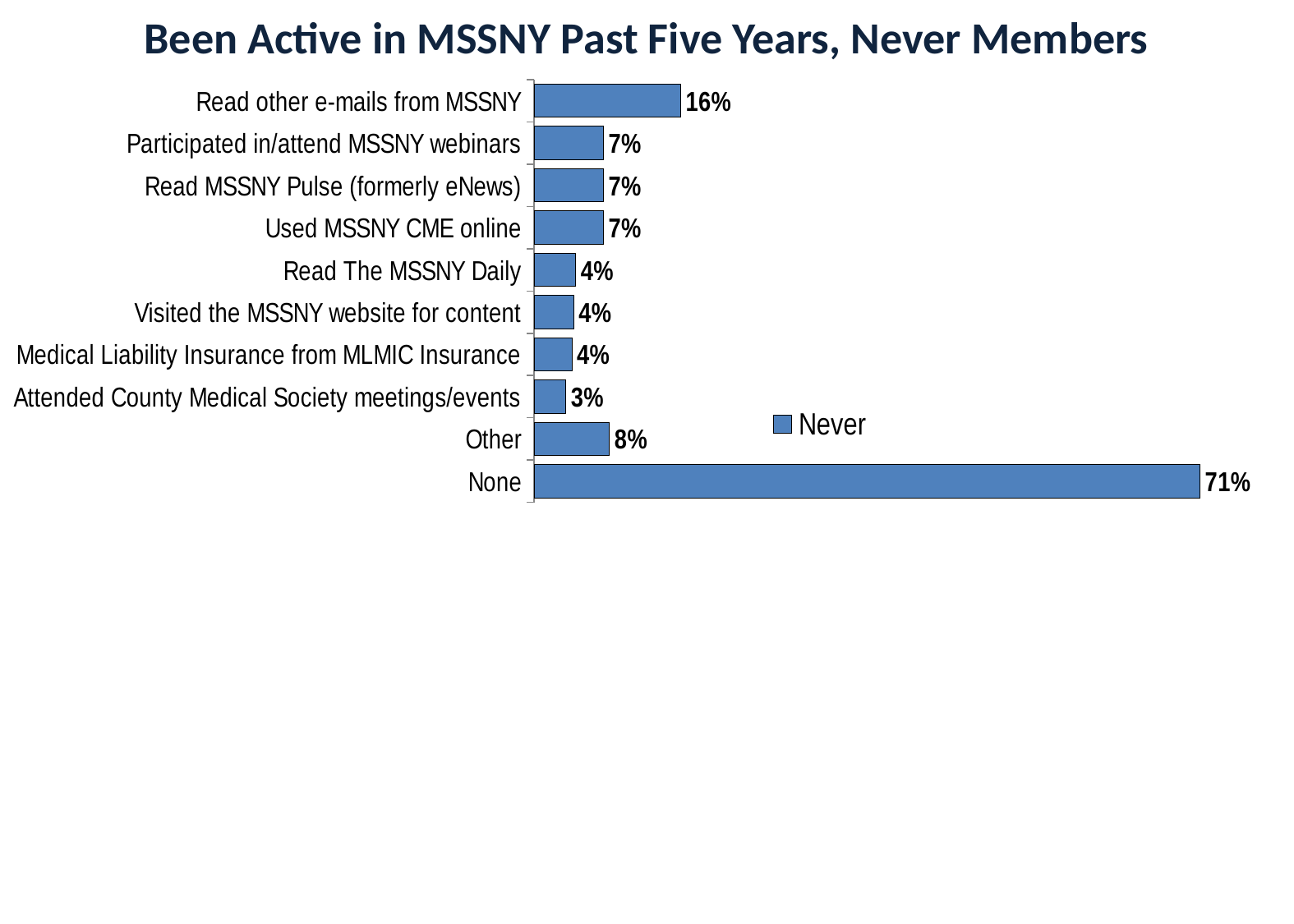
What kind of chart is shown on the slide? Bar chart How many categories are shown in the chart? 10 How many series does the legend list? 1 What is the value for "Used MSSNY CME online"? 7% What is the value for "None"? 71% Which is larger, the value for "Other" or the value for "Read The MSSNY Daily"? Other What is the difference between the values for "None" and "Read other e-mails from MSSNY"? 55% Which category has the lowest value? Attended County Medical Society meetings/events What is the value for "Attended County Medical Society meetings/events"? 3% What is the value for "Read other e-mails from MSSNY"? 16% Which category has the highest value? None What is the value for "Other"? 8%